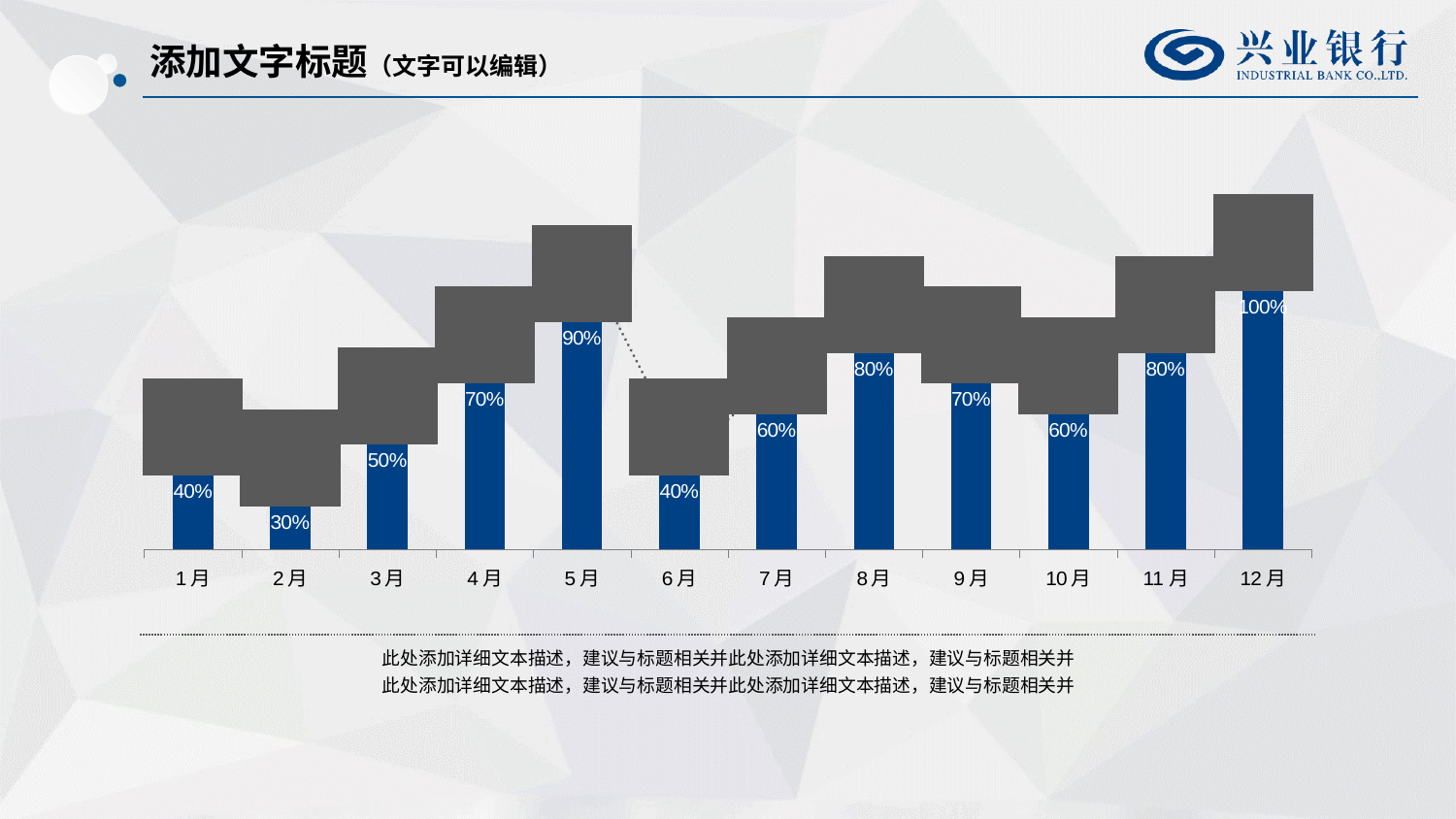
Which month has the highest value? 12月 What kind of chart is shown on the slide? Bar chart Which is larger, the value for 3月 or the value for 7月? 7月 How many months are shown on the x axis? 12 What is the value for 2月? 30% What is the value for 5月? 90% Which is larger, the value for 8月 or the value for 9月? 8月 What is the difference between the values for 12月 and 6月? 60% What is the value for 10月? 60% Which month has the lowest value? 2月 What is the difference between the values for 5月 and 4月? 20% Do the values rise or fall from 6月 to 8月? Rise